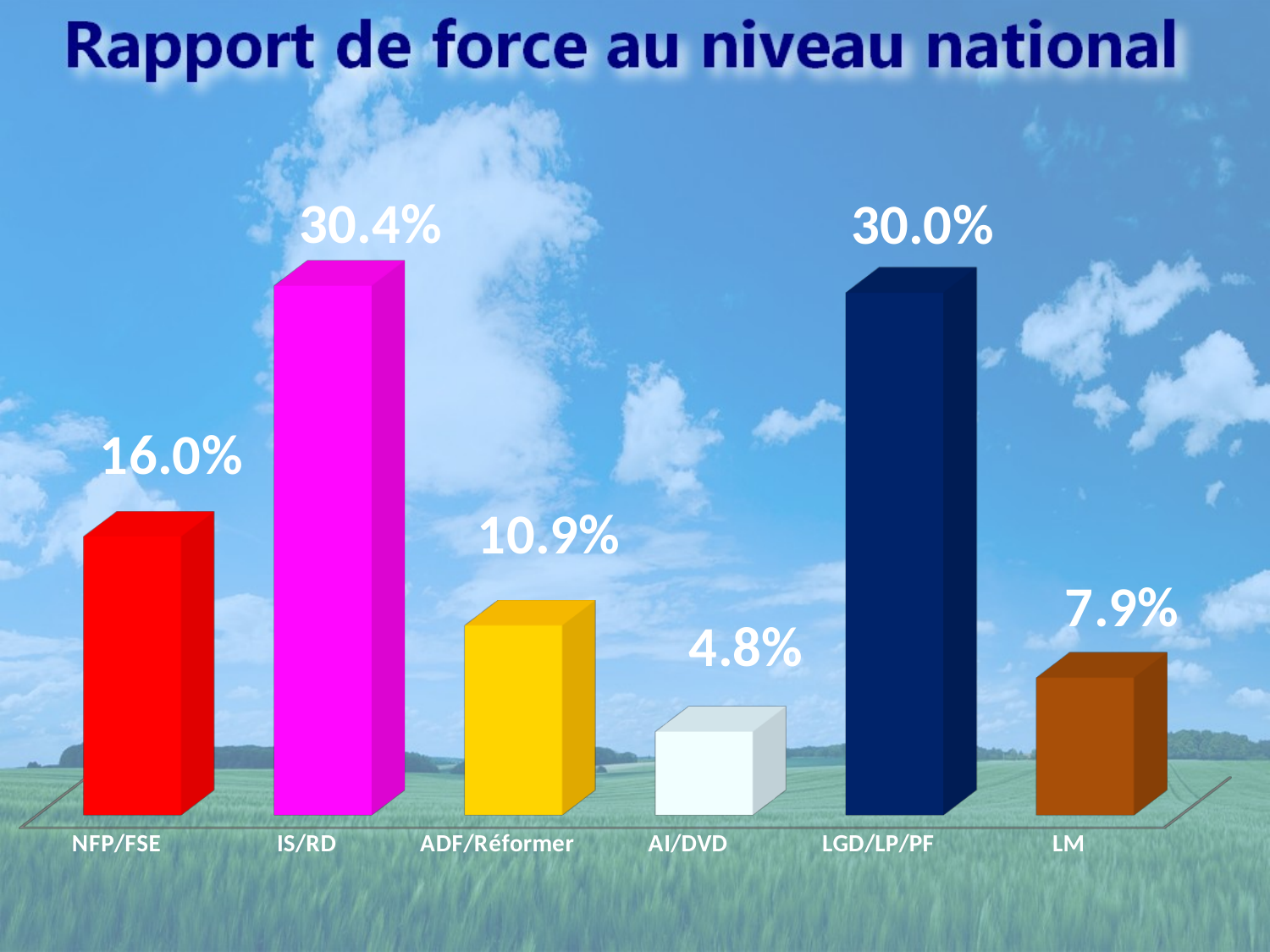
What is the difference between the values for NFP/FSE and ADF/Réformer? 5.1% What is the value for NFP/FSE? 16.0% How many categories are shown in the chart? 6 What kind of chart is shown on the slide? Bar chart Which category has the highest value? IS/RD What is the difference between the values for IS/RD and LGD/LP/PF? 0.4% Which category has the lowest value? AI/DVD Which is larger, the value for NFP/FSE or the value for LM? NFP/FSE What is the title of the chart? Rapport de force au niveau national What is the value for ADF/Réformer? 10.9% What is the value for LM? 7.9% What is the value for IS/RD? 30.4%